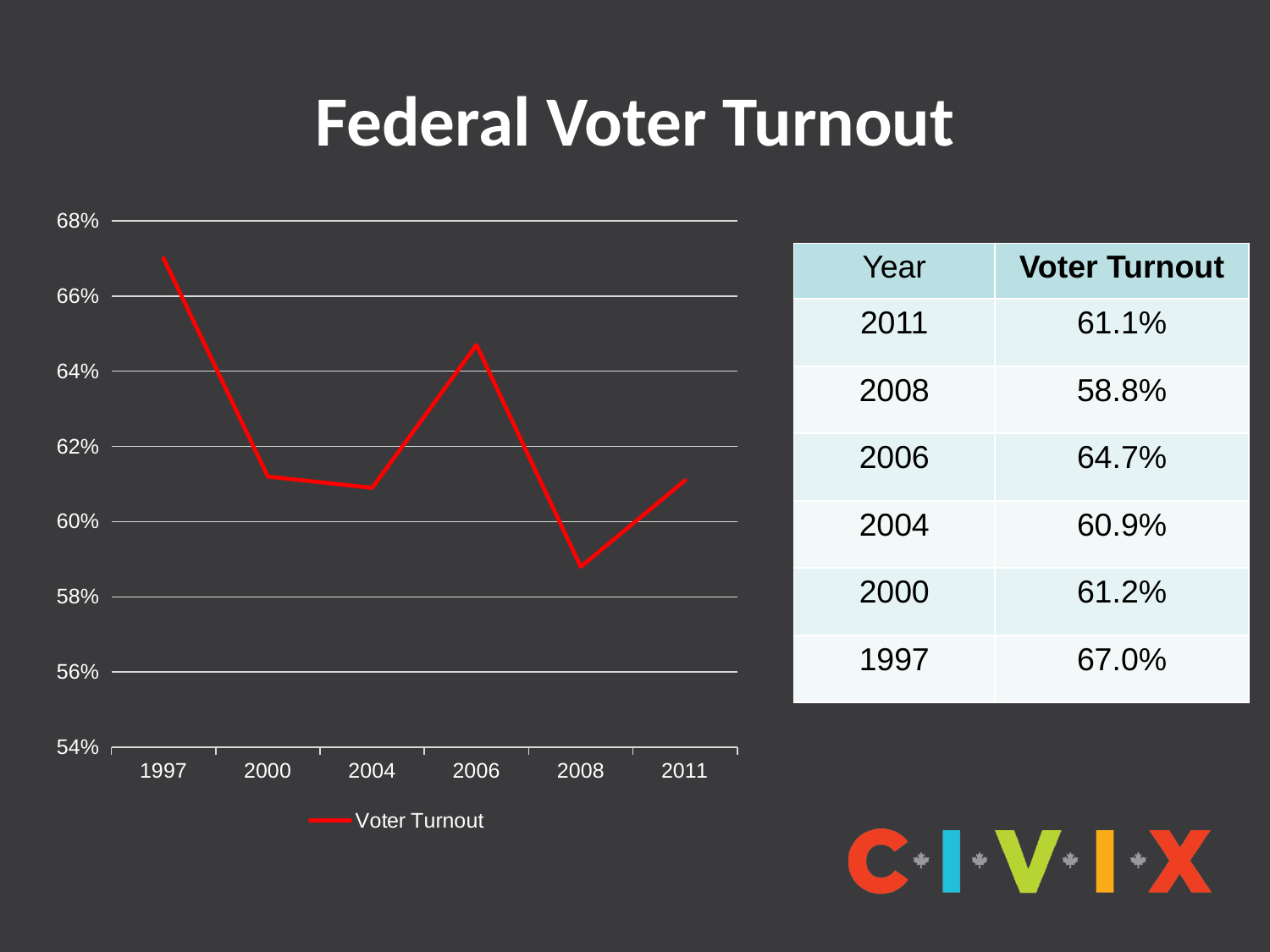
What is the difference in voter turnout between 1997 and 2008? 8.2 percentage points Is the voter turnout for 2008 greater or less than 60%? less Which year has the highest voter turnout? 1997 What is the voter turnout for 2006? 64.7% How many years are plotted on the chart? 6 What is the voter turnout for 1997? 67.0% How many series does the legend list? 1 Which year has the lowest voter turnout? 2008 What is the title of the chart? Federal Voter Turnout Which year has the higher voter turnout, 2006 or 2008? 2006 What kind of chart is shown on the slide? line chart Does voter turnout rise or fall from 1997 to 2004? fall